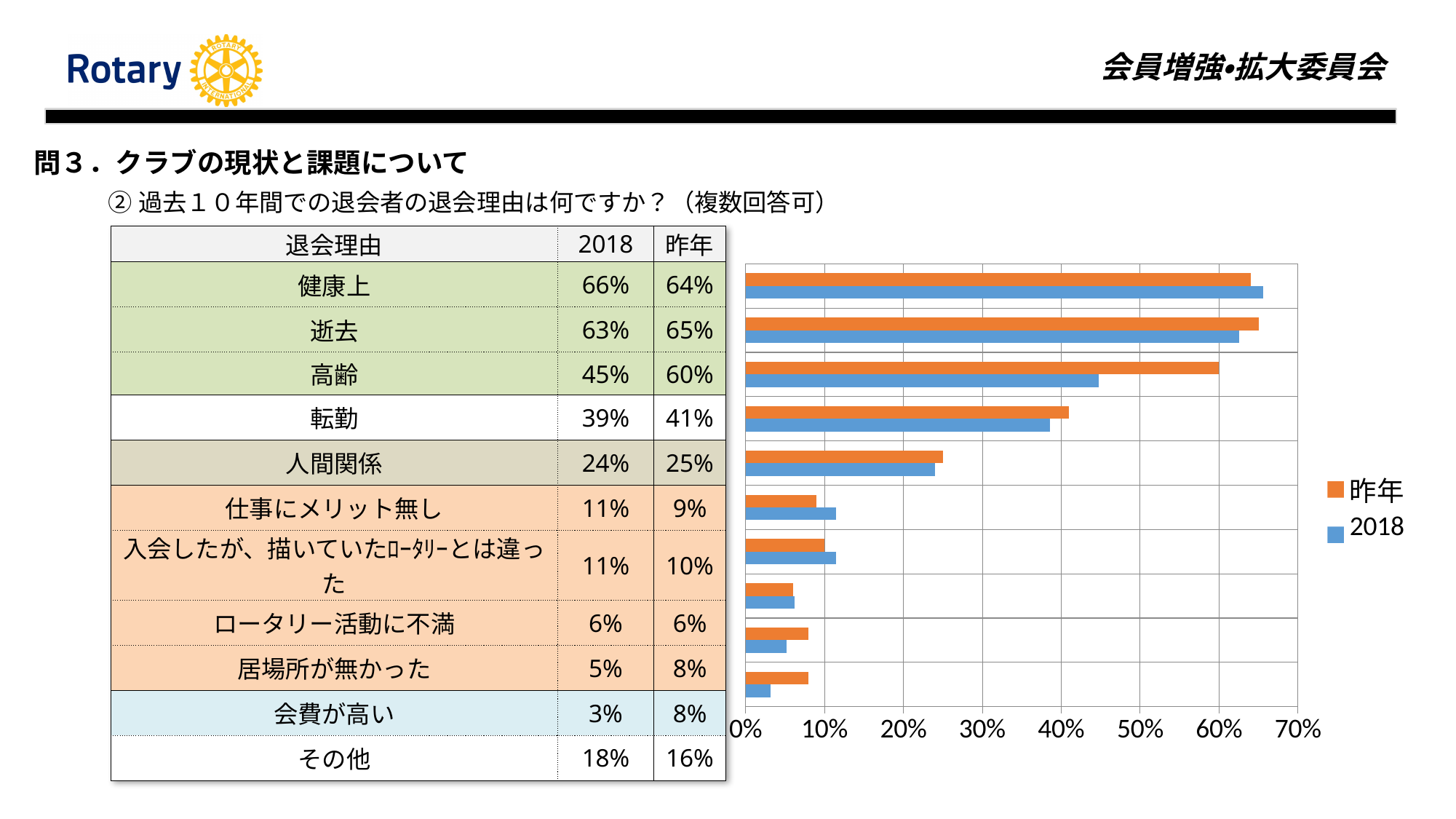
How many series does the chart legend list? 2 What kind of chart is shown on the slide? bar chart For 会費が高い, which is larger: the 昨年 value or the 2018 value? 昨年 How many categories (pairs of bars) are plotted in the chart? 10 Which category has the highest 2018 value? 健康上 What is the 2018 value for 健康上? 66% Which plotted category has the lowest 2018 value? 会費が高い What colour are the bars for the 2018 series? blue Is the 昨年 value for 高齢 greater or less than 50%? greater What is the difference between the 昨年 and 2018 values for 高齢? 15 percentage points What are the two entries in the chart legend? 昨年 and 2018 What is the 昨年 value for 高齢? 60%